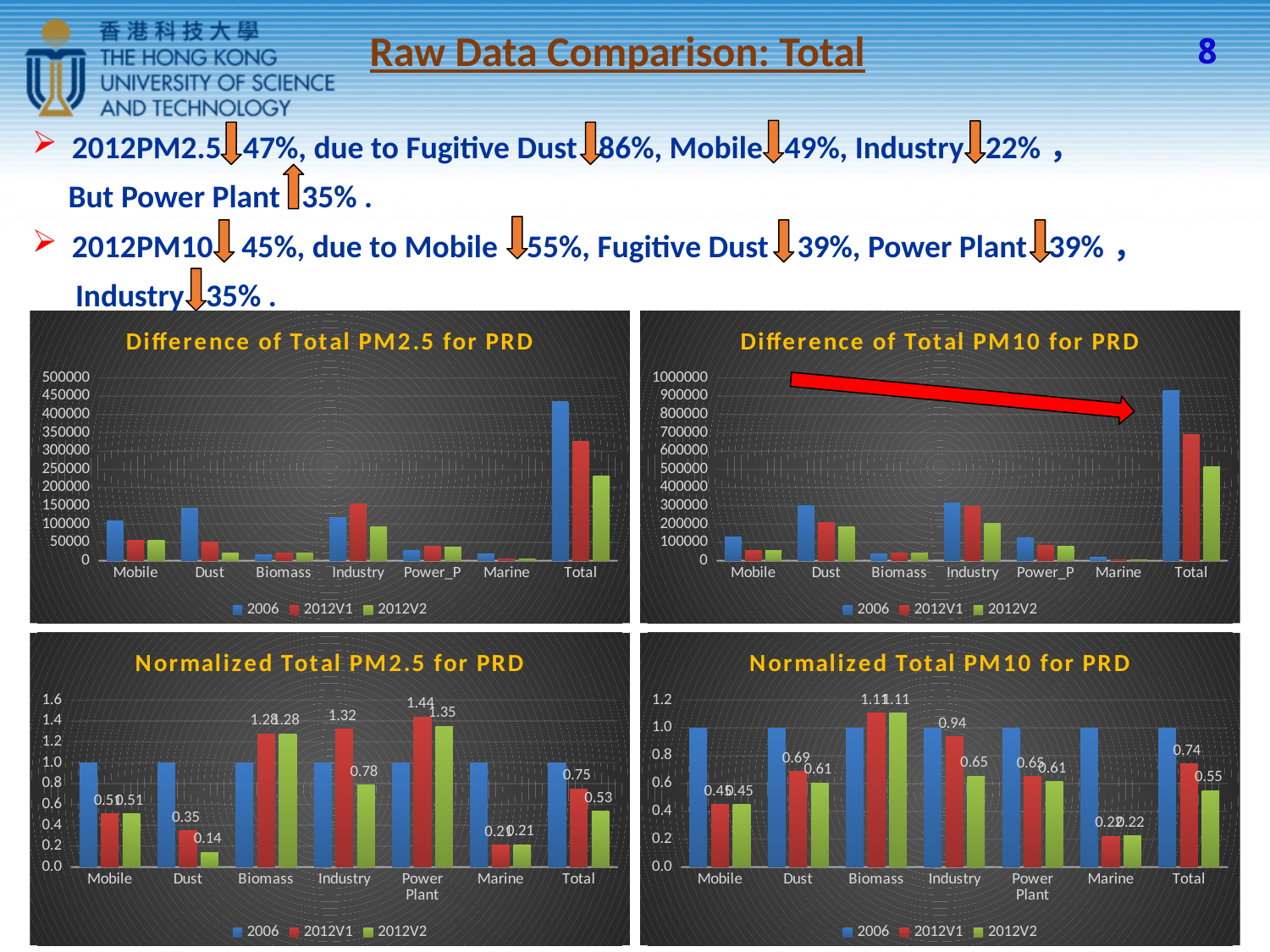
How many series does the legend of the Difference of Total PM10 for PRD chart list? 3 What type of chart is the Normalized Total PM2.5 for PRD chart? Bar chart In the Normalized Total PM10 for PRD chart, which is larger for Dust: the 2012V1 value or the 2012V2 value? 2012V1 In the Normalized Total PM10 for PRD chart, what is the 2012V1 value for Industry? 0.94 In the Normalized Total PM10 for PRD chart, which category has the lowest 2012V2 value? Marine In the Difference of Total PM2.5 for PRD chart, is the 2006 value for Total greater or less than 400000? greater In the Normalized Total PM2.5 for PRD chart, what is the 2012V2 value for Dust? 0.14 In the Normalized Total PM2.5 for PRD chart, what is the 2012V1 value for Power Plant? 1.44 In the Normalized Total PM2.5 for PRD chart, what is the difference between the 2012V1 and 2012V2 values for Industry? 0.54 In the Difference of Total PM10 for PRD chart, is the 2012V2 value for Total greater or less than 600000? less In the Normalized Total PM10 for PRD chart, what is the 2012V2 value for Total? 0.55 In the Normalized Total PM2.5 for PRD chart, which category has the highest 2012V1 value? Power Plant